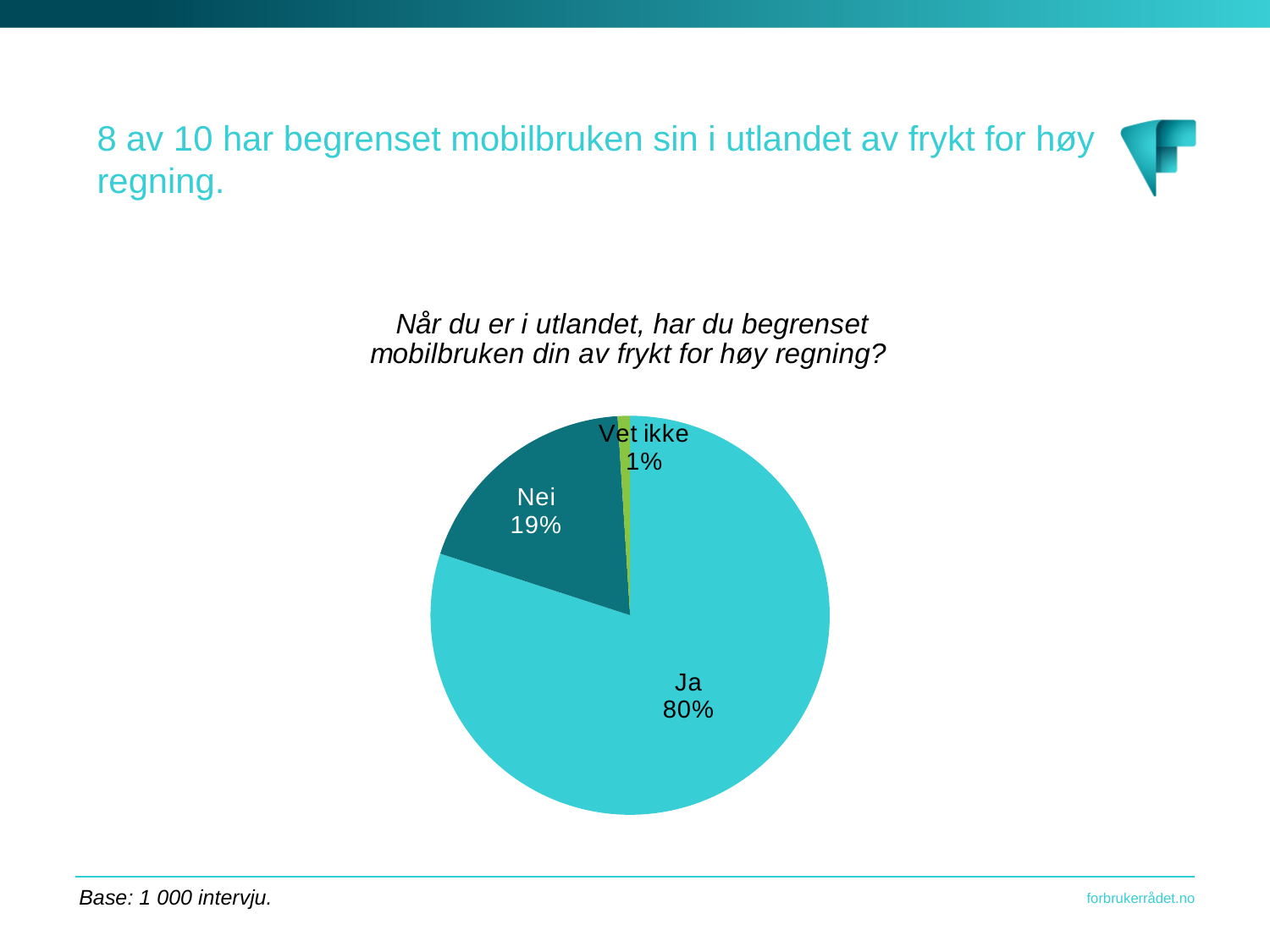
How many interviews form the base for the chart, according to the slide? 1 000 How many slices does the pie chart have? 3 What share of respondents answered "Ja"? 80% What share of respondents answered "Nei"? 19% Which is larger, the share for "Nei" or the share for "Vet ikke"? Nei What is the combined share of "Nei" and "Vet ikke"? 20% Which answer has the largest slice of the pie? Ja Which answer has the smallest slice of the pie? Vet ikke What share of respondents answered "Vet ikke"? 1% What question is the pie chart titled with? Når du er i utlandet, har du begrenset mobilbruken din av frykt for høy regning? What is the difference in percentage points between "Ja" and "Nei"? 61 What kind of chart is shown on the slide? pie chart